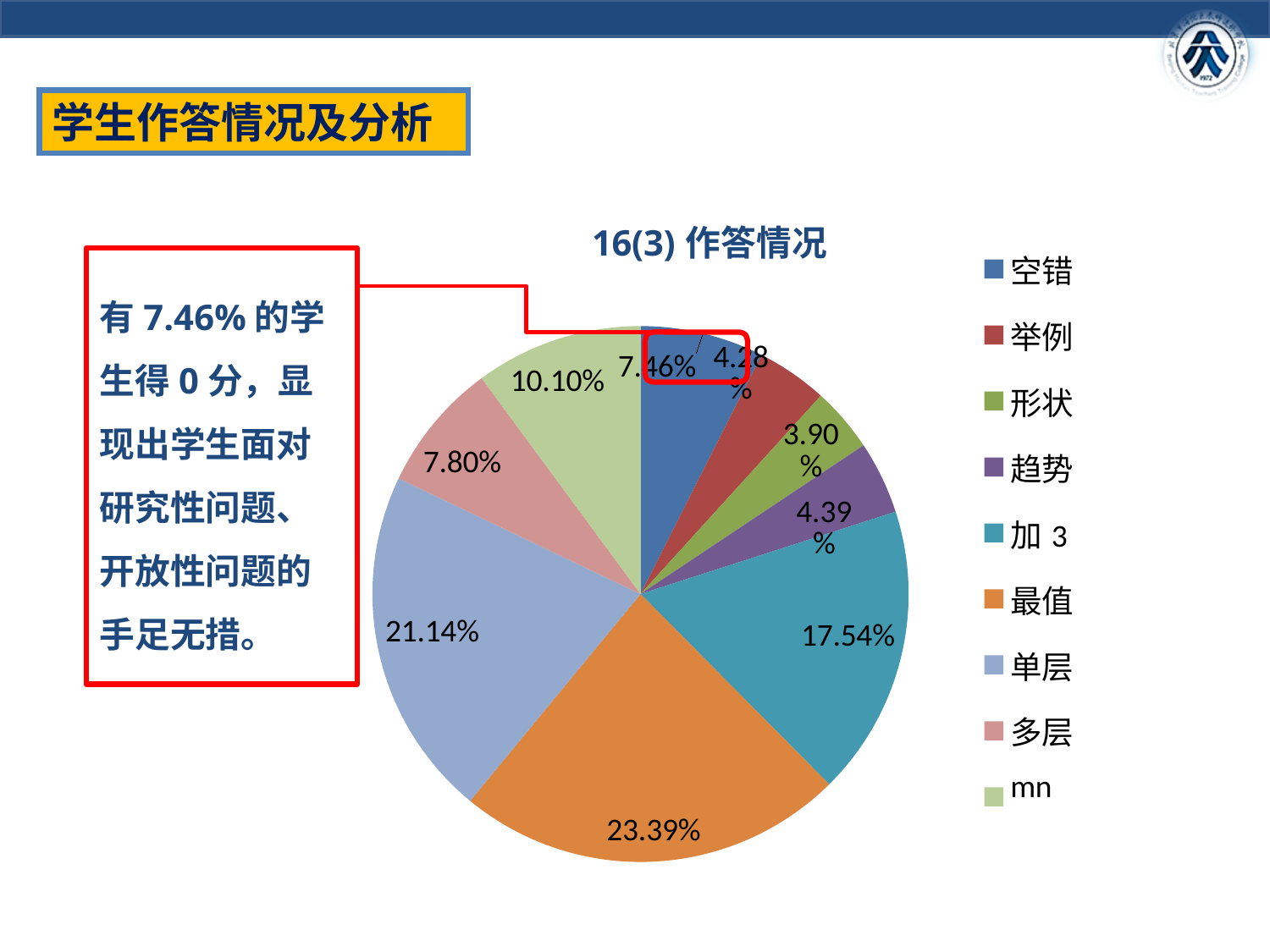
What type of chart is shown on the slide? pie chart What is the difference in percentage points between the 最值 slice and the 单层 slice? 2.25 Which category has the smallest share of the pie? 形状 What percentage does the 单层 slice represent? 21.14% What percentage does the 空错 slice represent? 7.46% What percentage does the 最值 slice represent? 23.39% What is the title of the chart? 16(3) 作答情况 How many categories does the legend list? 9 What percentage does the mn slice represent? 10.10% Which category has the largest share of the pie? 最值 Which is larger, the share for 单层 or the share for 加 3? 单层 What percentage does the 加 3 slice represent? 17.54%